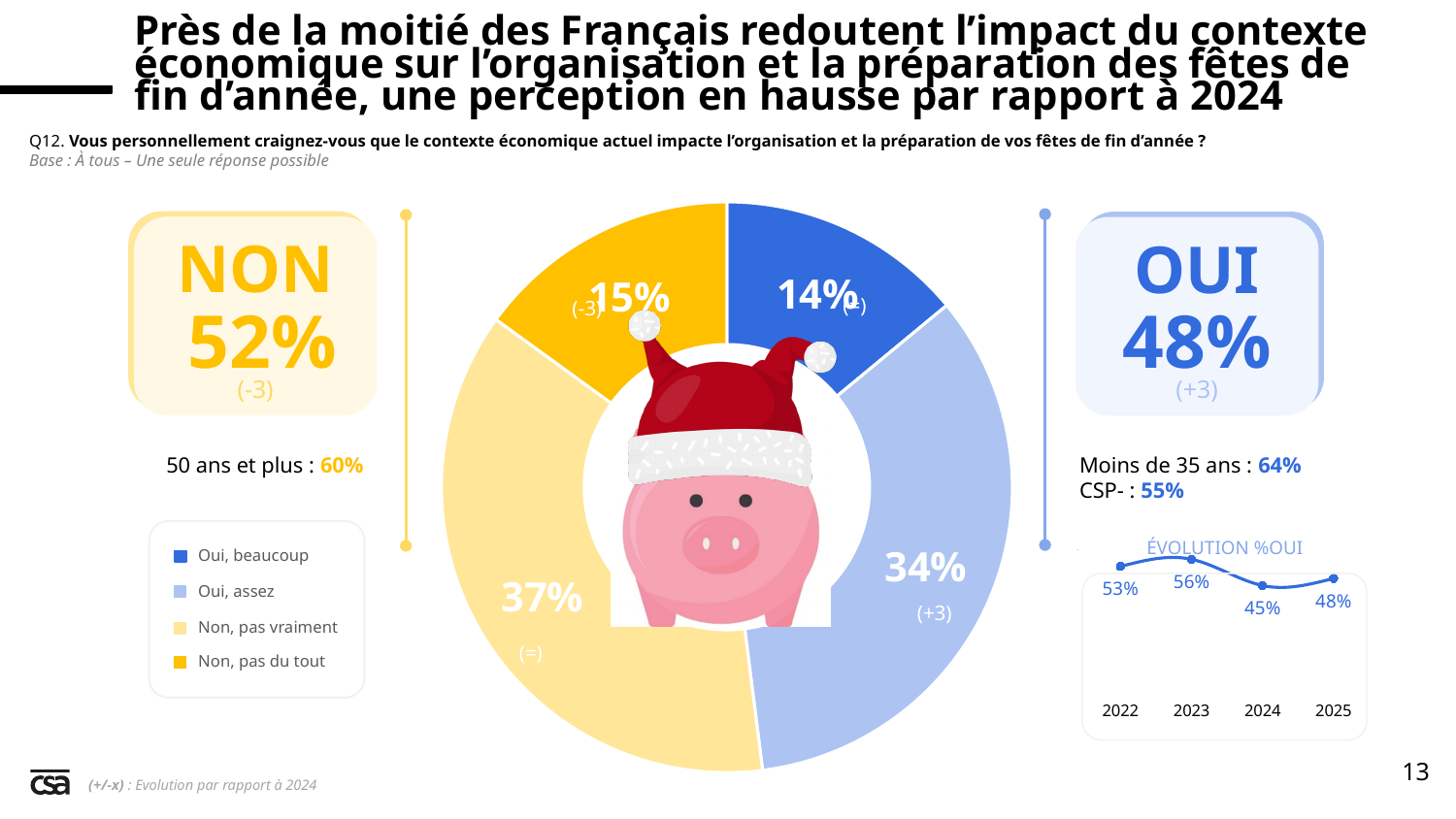
How many categories does the donut chart's legend list? 4 In the donut chart, which category has the largest share? Non, pas vraiment In the donut chart, which category has the smallest share? Oui, beaucoup In the donut chart, what is the difference between "Non, pas vraiment" and "Oui, assez"? 3 points In the "ÉVOLUTION %OUI" line chart, how many years are plotted? 4 What type of chart is the large chart in the centre of the slide? Donut (pie) chart In the donut chart, what percentage is shown for "Non, pas du tout"? 15% In the donut chart, which is larger: "Oui, beaucoup" or "Non, pas du tout"? Non, pas du tout In the "ÉVOLUTION %OUI" line chart, what is the difference between 2023 and 2024? 11 points In the "ÉVOLUTION %OUI" line chart, which year has the lowest value? 2024 In the donut chart, what percentage is shown for "Oui, assez"? 34% In the "ÉVOLUTION %OUI" line chart, what is the value for 2023? 56%